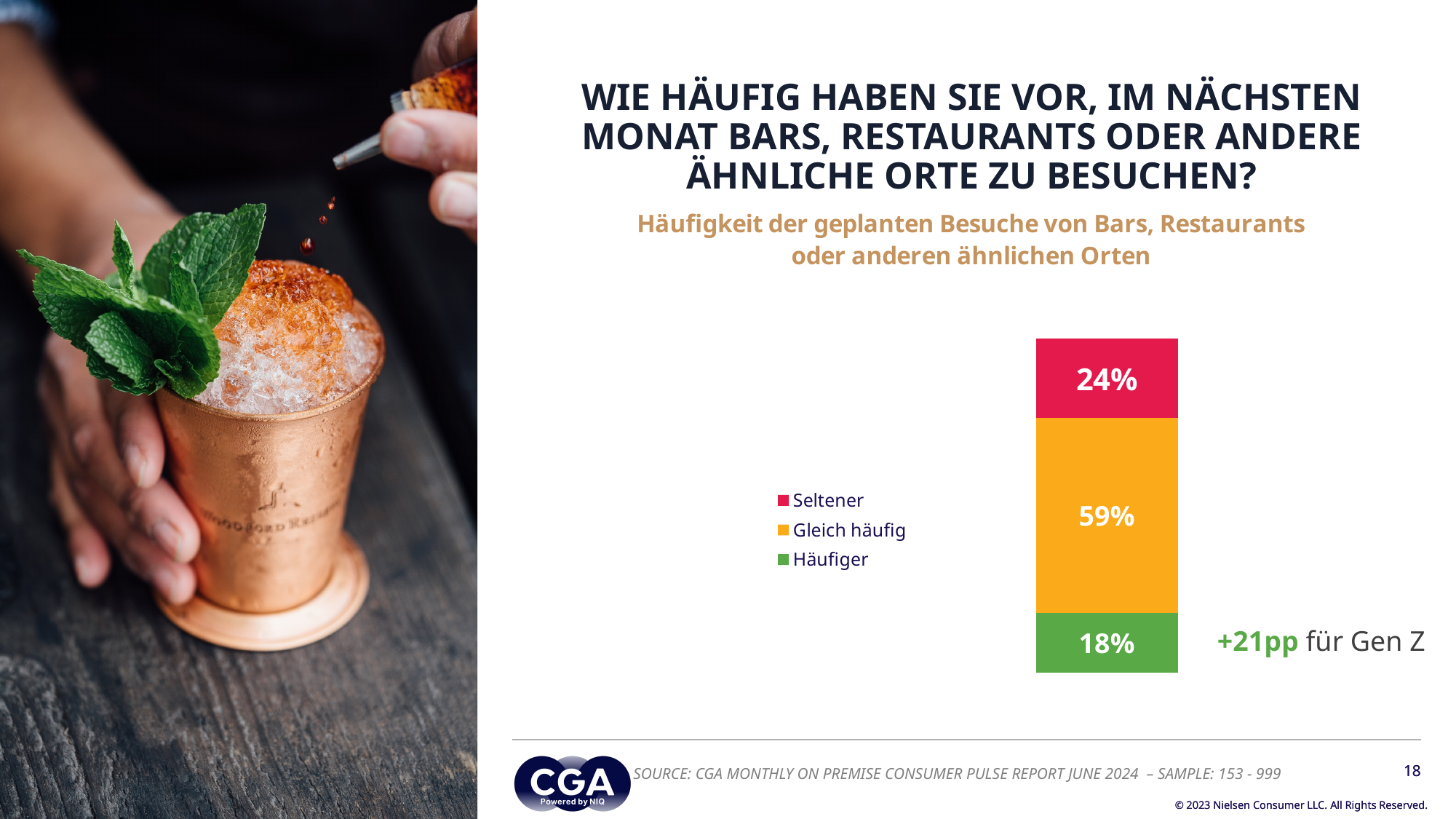
How many series does the legend list? 3 What annotation is shown next to the 'Häufiger' segment of the bar? +21pp für Gen Z Which response category has the smallest share in the stacked bar? Häufiger What percentage of respondents plan to visit bars, restaurants or similar places 'Seltener' (less often)? 24% Which is larger, the share for 'Seltener' or the share for 'Häufiger'? Seltener What colour represents 'Gleich häufig' in the chart? Orange What is the difference in percentage points between 'Seltener' and 'Häufiger'? 6 What percentage of respondents plan to visit 'Gleich häufig' (equally often)? 59% Which response category has the largest share in the stacked bar? Gleich häufig What percentage of respondents plan to visit 'Häufiger' (more often)? 18% What is the difference in percentage points between 'Gleich häufig' and 'Seltener'? 35 What kind of chart is shown on the slide? Stacked bar chart